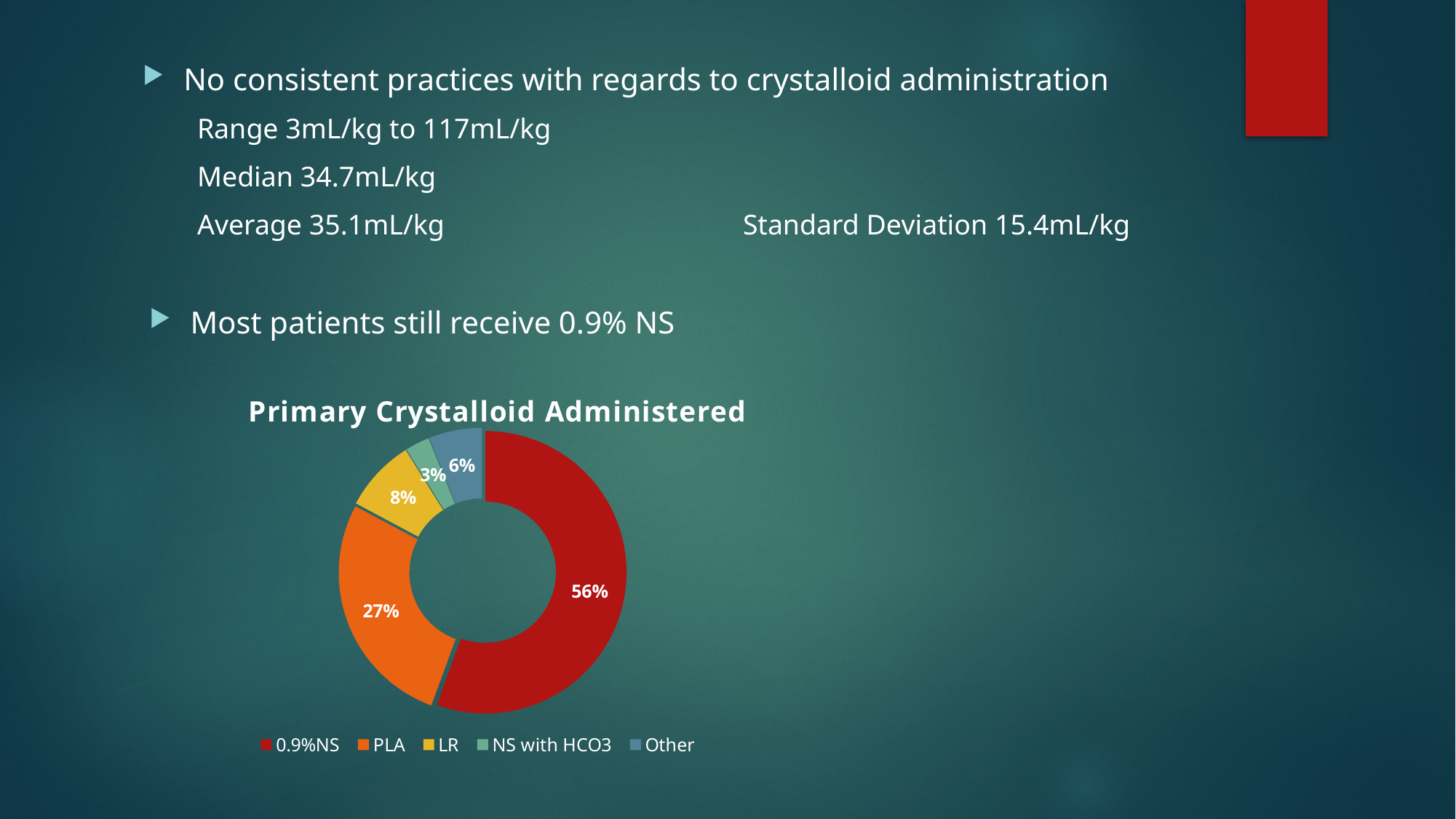
Which category has the largest slice? 0.9%NS What is the difference between the 0.9%NS and PLA shares? 29% What kind of chart is shown on the slide? Pie chart (doughnut) How many categories are shown in the chart? 5 Which is larger, the share for LR or the share for Other? LR Which category has the smallest slice? NS with HCO3 What share of the pie does 0.9%NS account for? 56% What is the value shown for NS with HCO3? 3% What is the value shown for Other? 6% What share of the pie does PLA account for? 27% What is the value shown for LR? 8% What is the title of the chart? Primary Crystalloid Administered